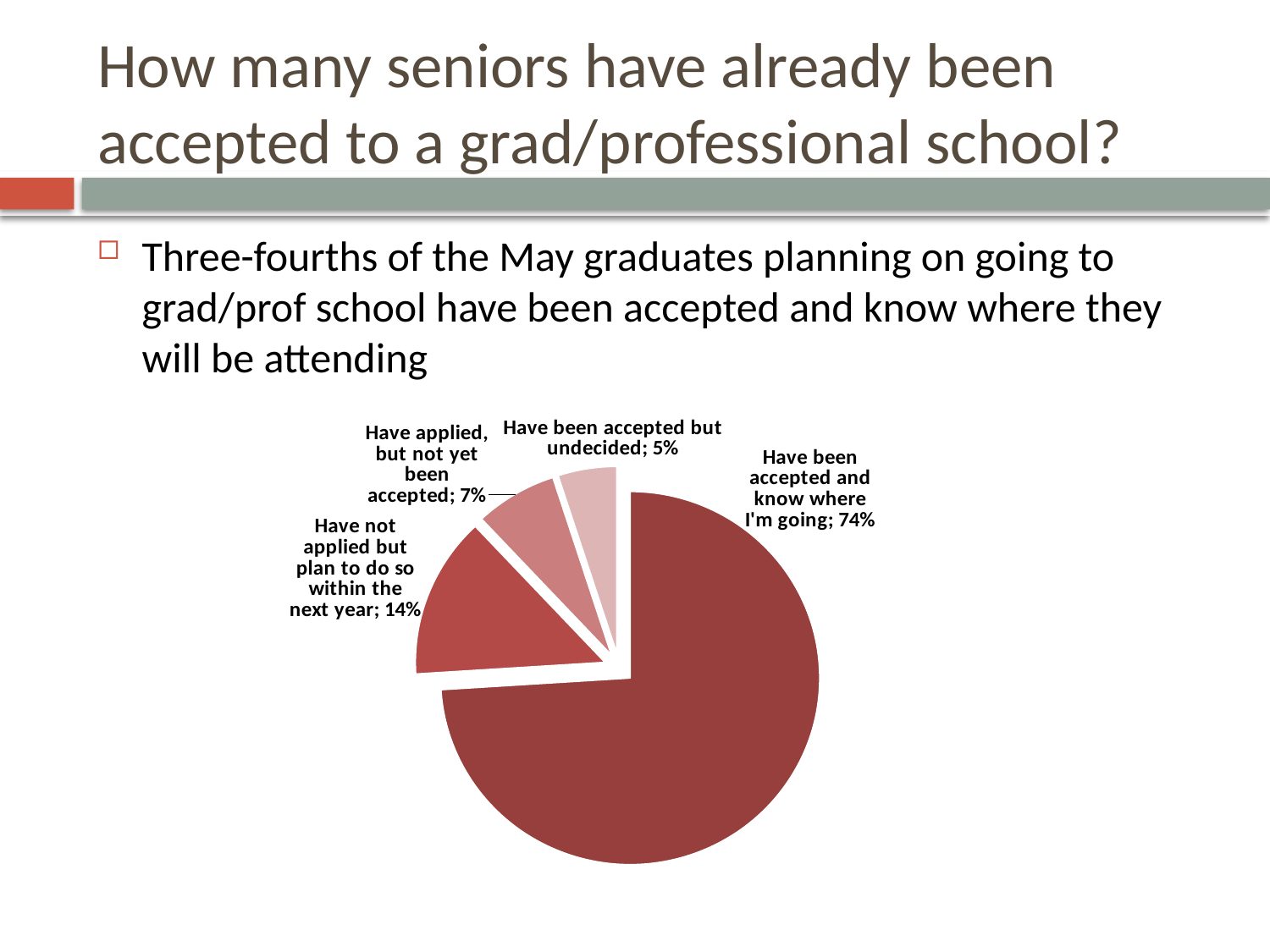
What is the combined share of 'Have applied, but not yet been accepted' and 'Have been accepted but undecided'? 12% What is the value for 'Have been accepted but undecided'? 5% What kind of chart is shown on the slide? pie chart How many slices does the pie chart have? 4 What is the value for 'Have applied, but not yet been accepted'? 7% What is the difference between 'Have not applied but plan to do so within the next year' and 'Have applied, but not yet been accepted'? 7% Which category has the largest slice of the pie? Have been accepted and know where I'm going Which category has the smallest slice of the pie? Have been accepted but undecided What share of the pie is 'Have been accepted and know where I'm going'? 74% What is the difference between 'Have been accepted and know where I'm going' and 'Have not applied but plan to do so within the next year'? 60% What is the value for 'Have not applied but plan to do so within the next year'? 14% Which is larger: 'Have applied, but not yet been accepted' or 'Have been accepted but undecided'? Have applied, but not yet been accepted